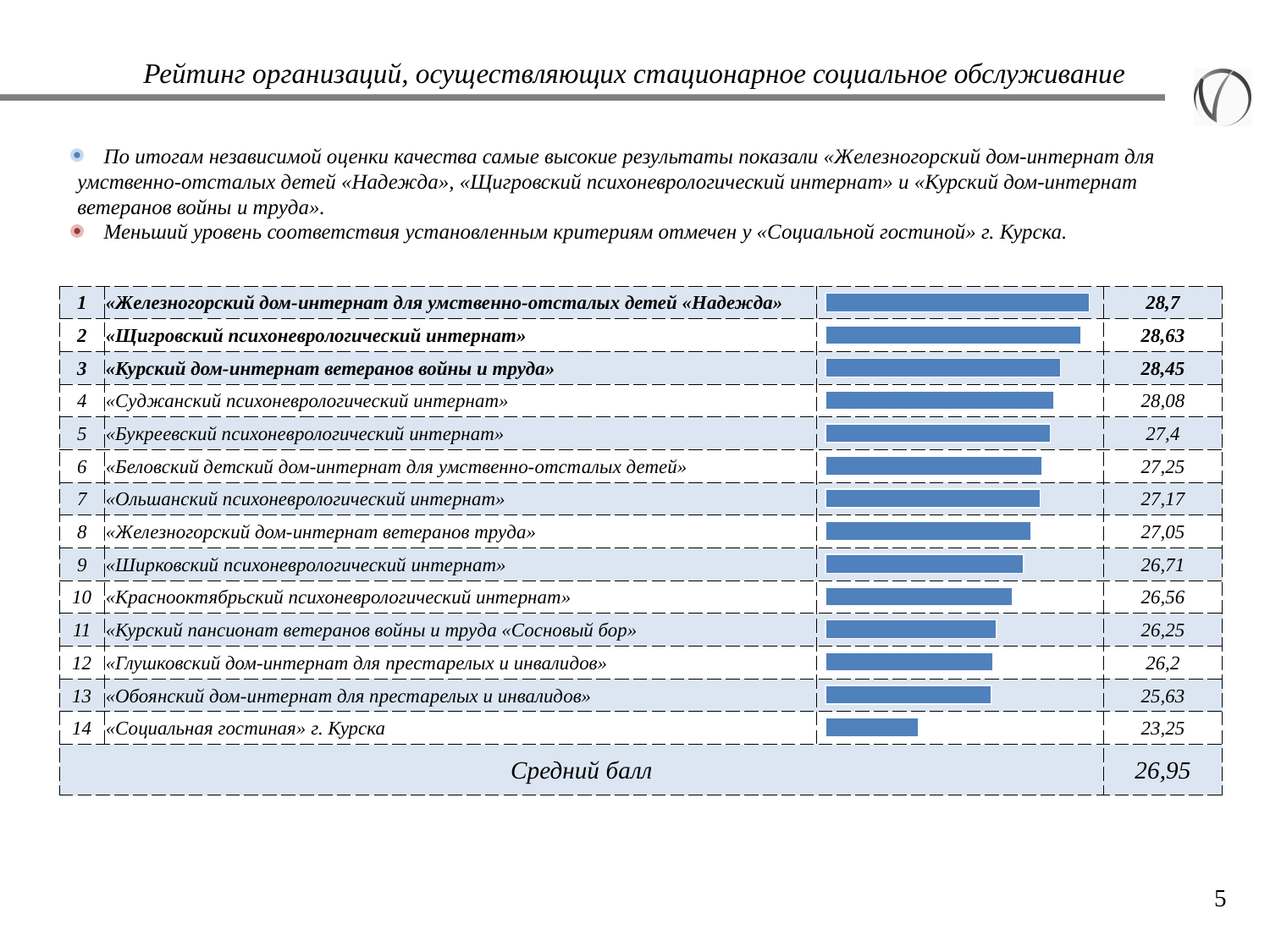
How many organisations are ranked in the chart? 14 What is the difference between the scores of «Букреевский психоневрологический интернат» and «Глушковский дом-интернат для престарелых и инвалидов»? 1,2 Which organisation has the lowest score? «Социальная гостиная» г. Курска Which has a higher score: «Суджанский психоневрологический интернат» or «Букреевский психоневрологический интернат»? «Суджанский психоневрологический интернат» What is the score for «Щигровский психоневрологический интернат»? 28,63 Do the scores rise or fall going down the list from rank 1 to rank 14? Fall What is the score for «Социальная гостиная» г. Курска? 23,25 What is the score for «Ширковский психоневрологический интернат»? 26,71 What kind of chart is used to show the scores? Bar chart What is the average score (Средний балл) shown at the bottom of the chart? 26,95 What is the difference between the highest score (28,7) and the lowest score (23,25)? 5,45 Which organisation has the highest score? «Железногорский дом-интернат для умственно-отсталых детей «Надежда»